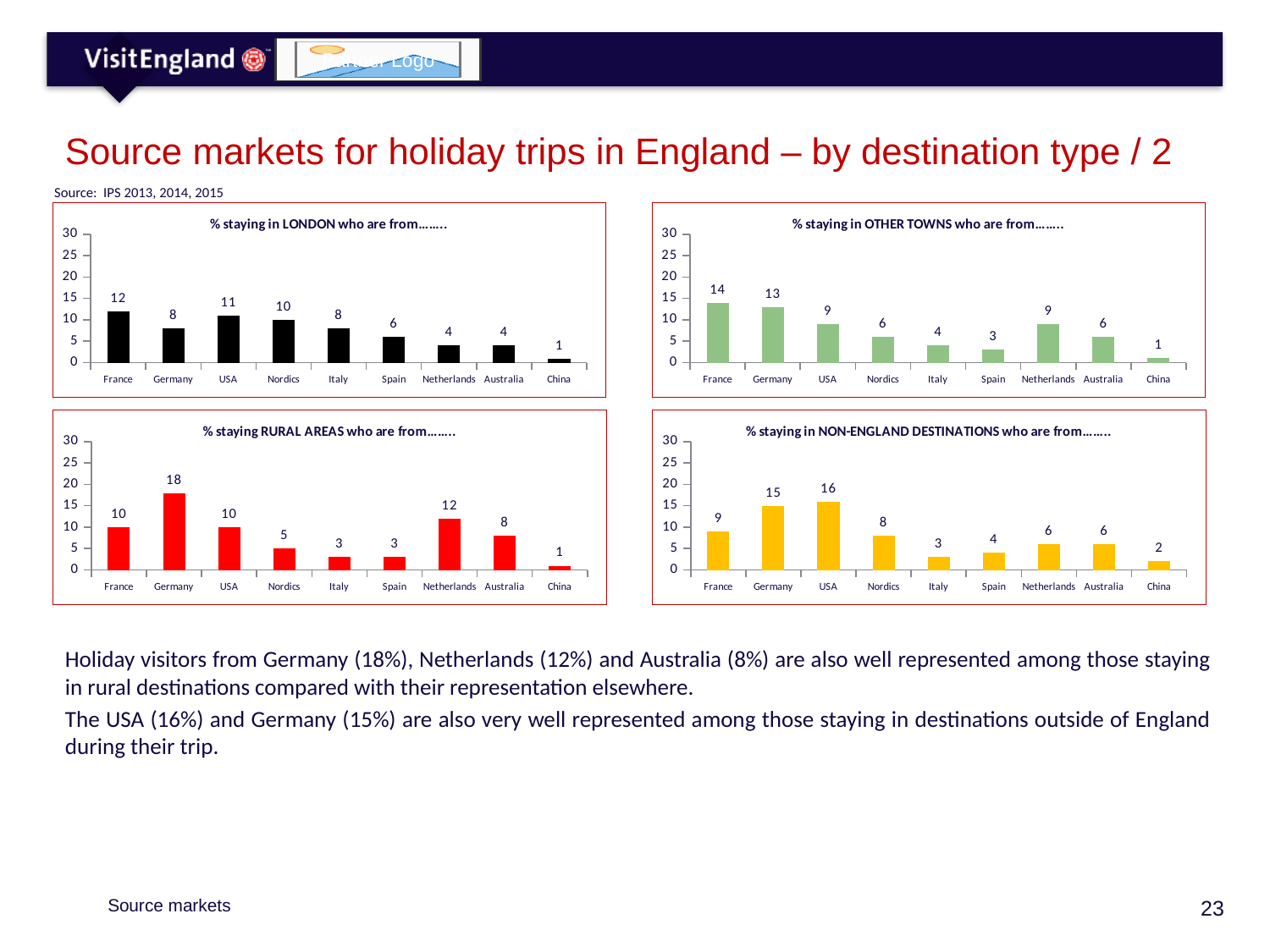
What type of chart is the '% staying in RURAL AREAS who are from……..' chart? Bar chart What colour are the bars in the '% staying in OTHER TOWNS who are from……..' chart? Green In the '% staying in OTHER TOWNS who are from……..' chart, which country has the highest value? France In the '% staying in RURAL AREAS who are from……..' chart, which country has the lowest value? China In the '% staying in NON-ENGLAND DESTINATIONS who are from……..' chart, what is the value for Nordics? 8 How many countries are shown on the x axis of the '% staying in LONDON who are from……..' chart? 9 In the '% staying in NON-ENGLAND DESTINATIONS who are from……..' chart, which country has the highest value? USA In the '% staying in OTHER TOWNS who are from……..' chart, which is larger, the value for Netherlands or the value for Australia? Netherlands In the '% staying in LONDON who are from……..' chart, what is the value for France? 12 In the '% staying in RURAL AREAS who are from……..' chart, what is the value for Germany? 18 In the '% staying in NON-ENGLAND DESTINATIONS who are from……..' chart, what is the difference between the values for USA and Germany? 1 In the '% staying in LONDON who are from……..' chart, what is the difference between the values for France and Spain? 6